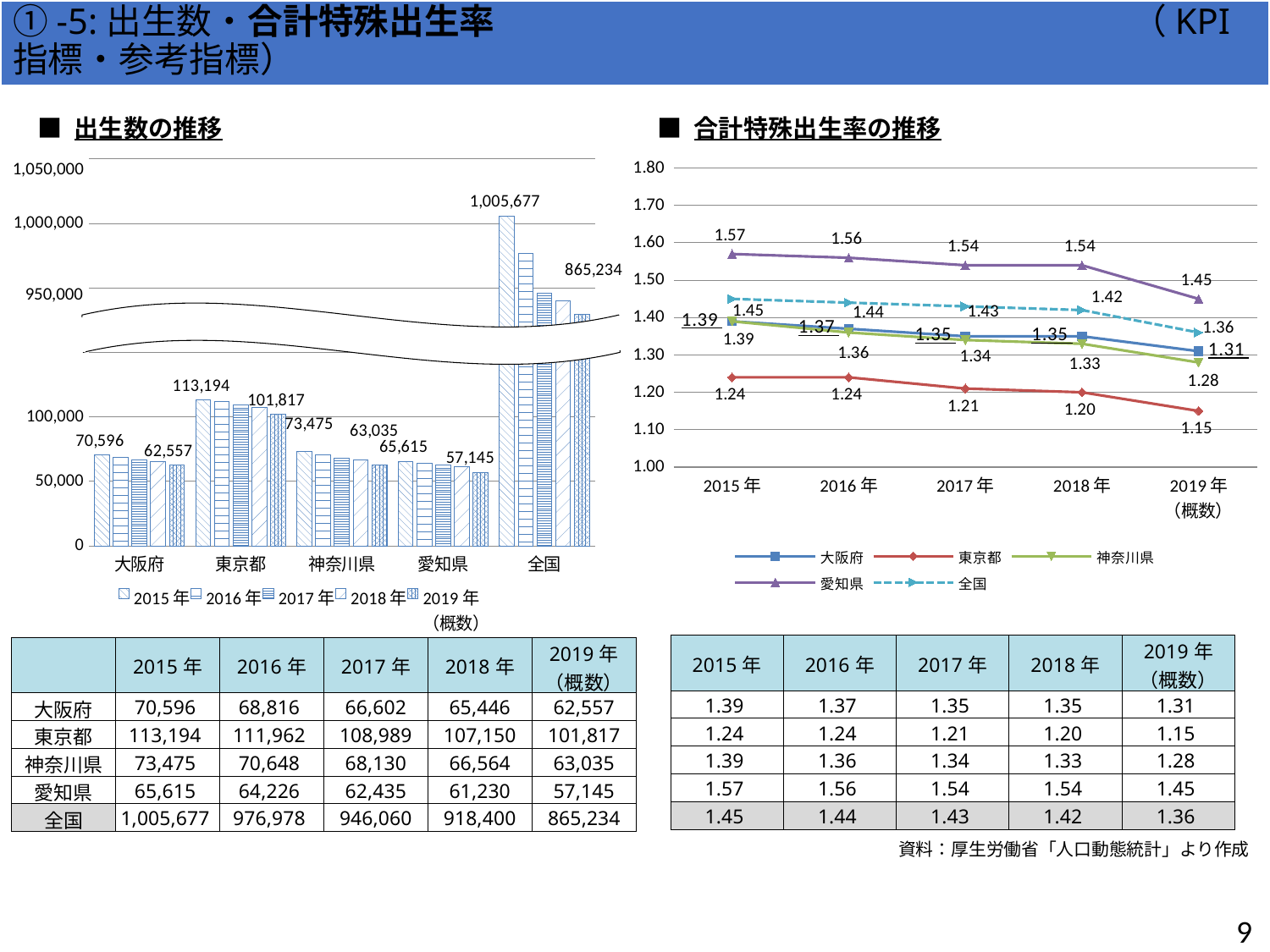
On the 出生数の推移 chart, what is the 2019年(概数) value for 全国? 865,234 What kind of chart is the 出生数の推移 chart? bar chart On the 合計特殊出生率の推移 chart, do the values for 全国 rise or fall from 2015年 to 2019年(概数)? fall On the 合計特殊出生率の推移 chart, is the 2015年 value for 大阪府 larger or smaller than the 2015年 value for 東京都? larger On the 出生数の推移 chart, how many series does the legend list? 5 On the 出生数の推移 chart, what is the difference between the 2015年 and 2019年(概数) values for 東京都? 11,377 On the 合計特殊出生率の推移 chart, which series has the lowest value in 2019年(概数)? 東京都 On the 出生数の推移 chart, what is the 2015年 value for 大阪府? 70,596 On the 合計特殊出生率の推移 chart, what is the 2017年 value for 愛知県? 1.54 What kind of chart is the 合計特殊出生率の推移 chart? line chart On the 出生数の推移 chart, how many categories are shown on the x axis? 5 On the 出生数の推移 chart, which category has the highest 2015年 value? 全国